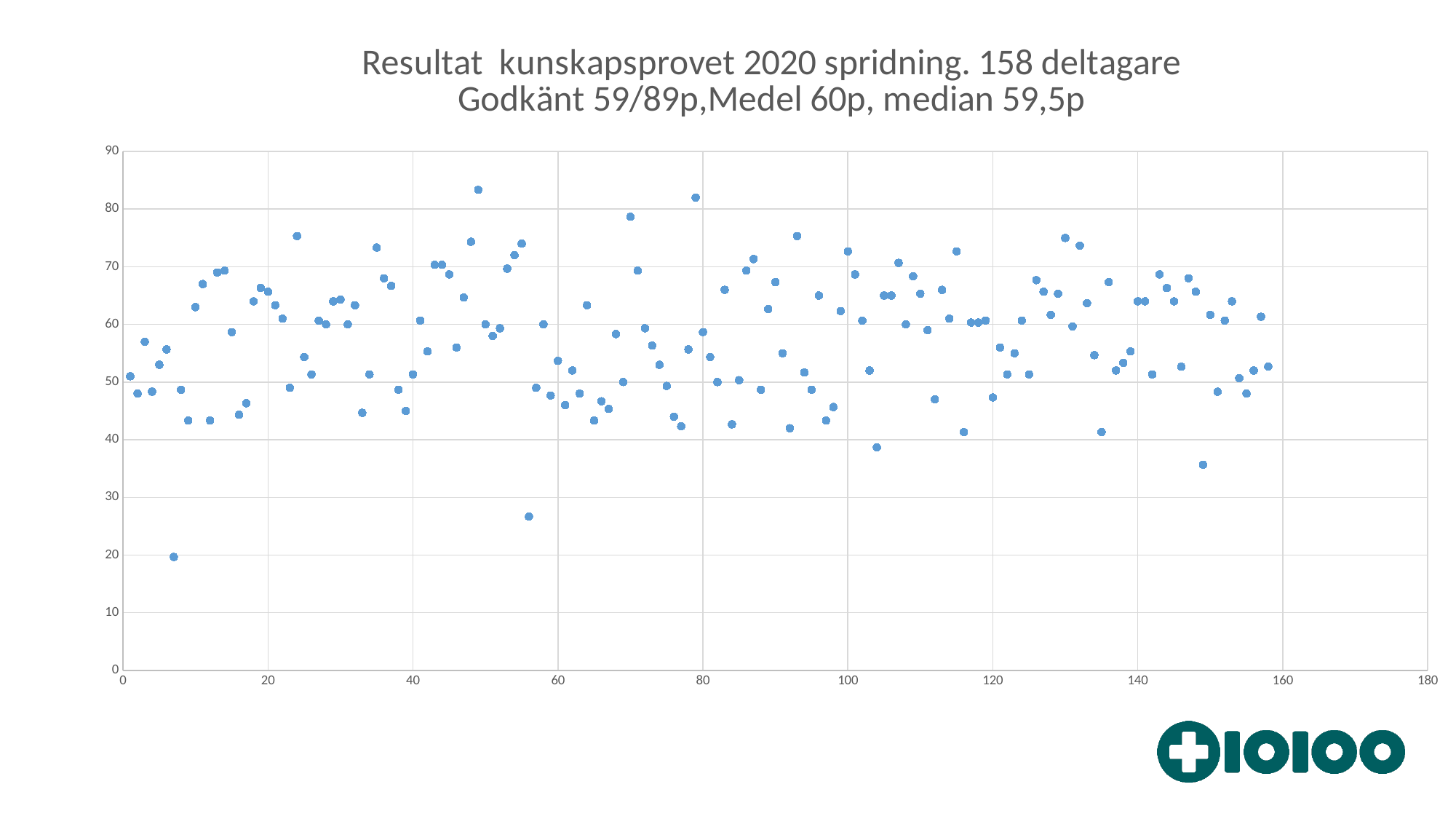
Is the value of the highest point on the chart (near x = 49) greater or less than 80? greater Which point has the lower value: the point near x = 7 or the point near x = 56? the point near x = 7 What median score does the chart title state? 59,5p Is the value of the point near x = 56 greater or less than 30? less Is the value of the point near x = 79 greater or less than 80? greater What is the title of the chart? Resultat kunskapsprovet 2020 spridning. 158 deltagare Godkänt 59/89p,Medel 60p, median 59,5p What mean (Medel) score does the chart title state? 60p What passing threshold (Godkänt) does the chart title state? 59/89p According to the chart title, how many participants (deltagare) are plotted? 158 What is the highest value shown on the y axis? 90 What kind of chart is shown on the slide? scatter chart